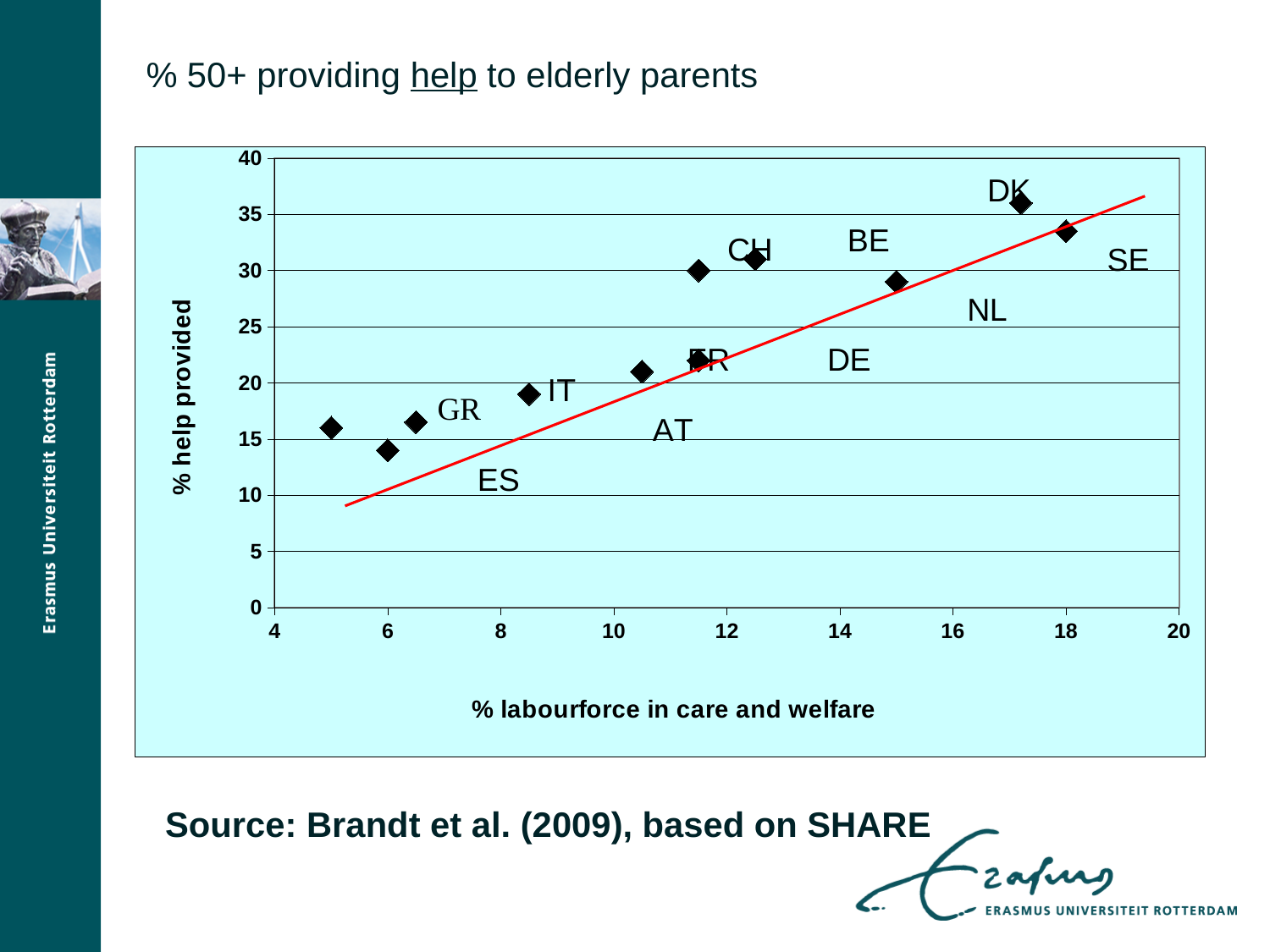
What is the title of the chart? % 50+ providing help to elderly parents What is the maximum value shown on the vertical axis? 40 Is the % help provided for SE greater or less than 30? greater Is the % help provided for IT greater or less than 25? less Is the % help provided for GR greater or less than 20? less How many country labels appear in the chart? 11 What is the label of the horizontal axis? % labourforce in care and welfare How many data points are plotted in the chart? 11 What kind of chart is shown on the slide? scatter plot Does % help provided generally rise or fall as % labourforce in care and welfare increases? rise Which country has the highest % help provided? DK